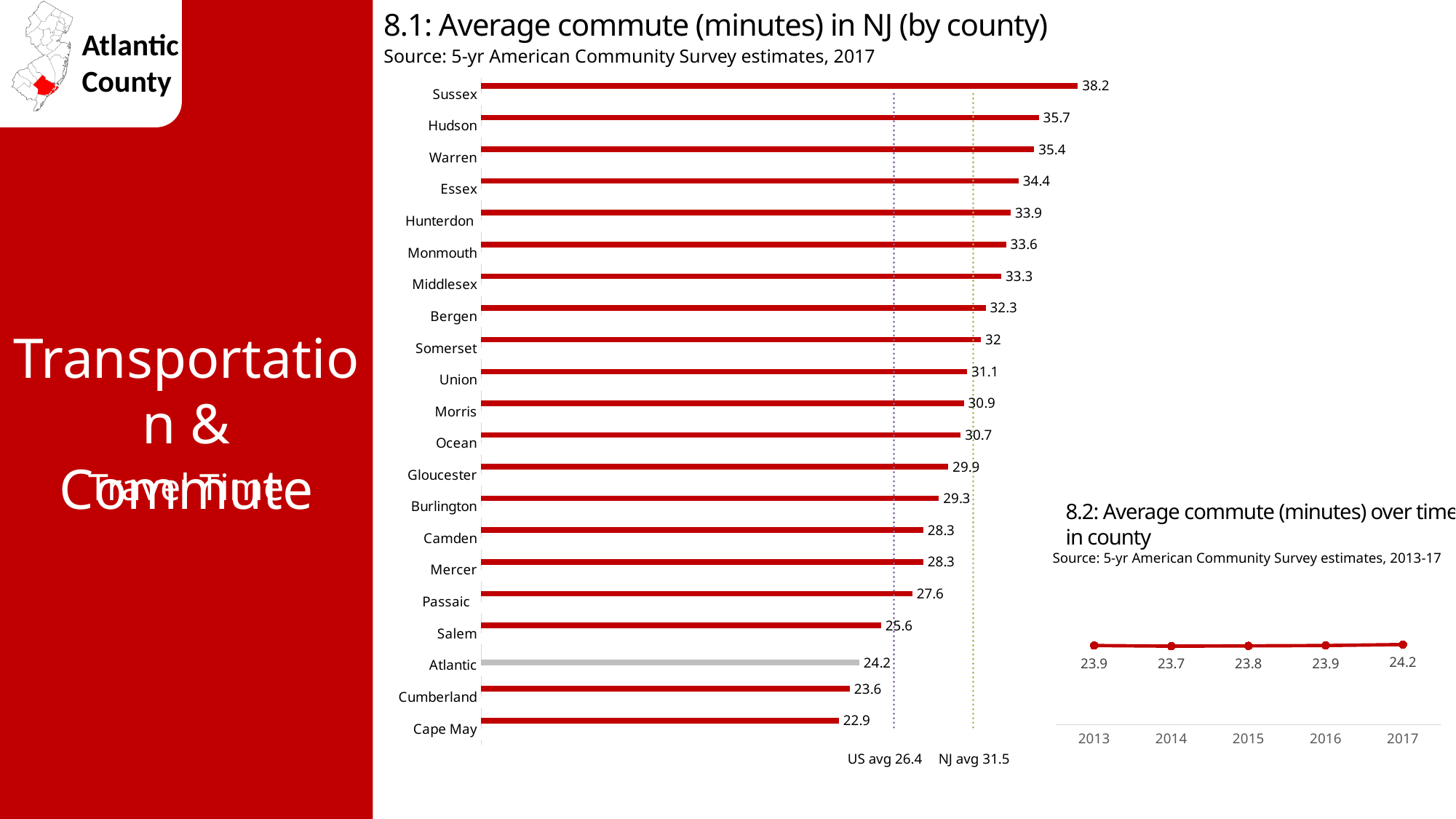
In chart 8.2 (Average commute over time in county), what is the value for 2014? 23.7 In chart 8.1 (Average commute in NJ by county), which county has the lowest average commute? Cape May In chart 8.1 (Average commute in NJ by county), which county has the highest average commute? Sussex In chart 8.2 (Average commute over time in county), what is the difference between the 2017 and 2013 values? 0.3 In chart 8.1 (Average commute in NJ by county), what is the value for Passaic? 27.6 In chart 8.1 (Average commute in NJ by county), what is the difference between the Sussex and Cape May values? 15.3 In chart 8.1 (Average commute in NJ by county), what is the average commute for Atlantic County? 24.2 In chart 8.1 (Average commute in NJ by county), how many counties are shown? 21 In chart 8.1 (Average commute in NJ by county), which has a longer average commute, Hudson or Bergen? Hudson In chart 8.2 (Average commute over time in county), how many years are plotted? 5 What type of chart is chart 8.1 (Average commute in NJ by county)? Bar chart In chart 8.1 (Average commute in NJ by county), what NJ average is marked by the dotted reference line? 31.5